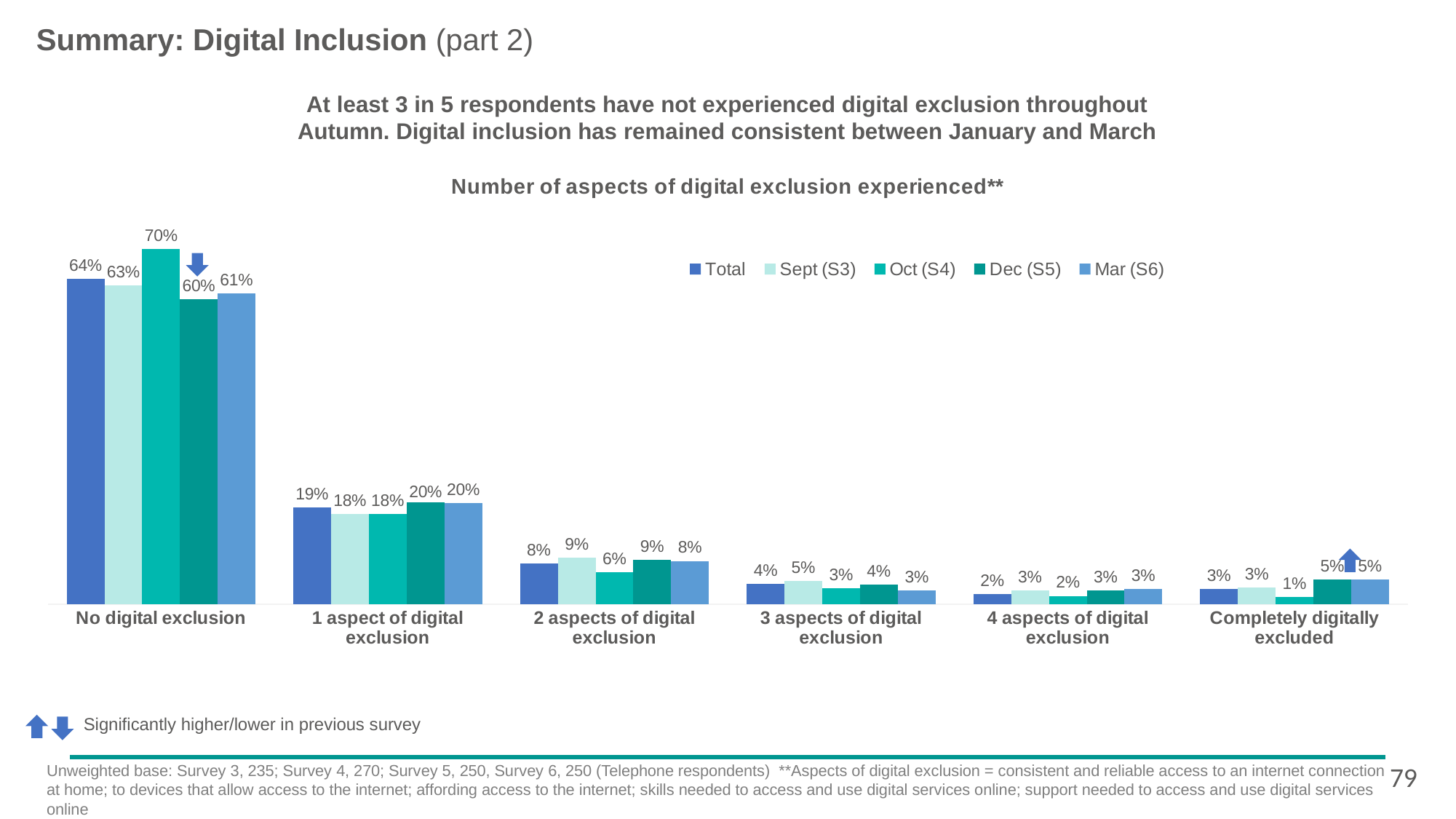
Which is larger for '2 aspects of digital exclusion': the Sept (S3) value or the Oct (S4) value? Sept (S3) What is the Dec (S5) value for 'Completely digitally excluded'? 5% Which survey series has the lowest value for 'Completely digitally excluded'? Oct (S4) What is the title of the chart? Number of aspects of digital exclusion experienced** What is the Oct (S4) value for 'No digital exclusion'? 70% Do the Total values rise or fall moving from 'No digital exclusion' to '4 aspects of digital exclusion'? Fall What is the Total value for '1 aspect of digital exclusion'? 19% How many series does the legend list? 5 What is the difference between the Oct (S4) and Dec (S5) values for 'No digital exclusion'? 10% Which survey series has the highest value for 'No digital exclusion'? Oct (S4) What kind of chart is shown on the slide? Bar chart How many categories are shown on the x axis of the chart? 6